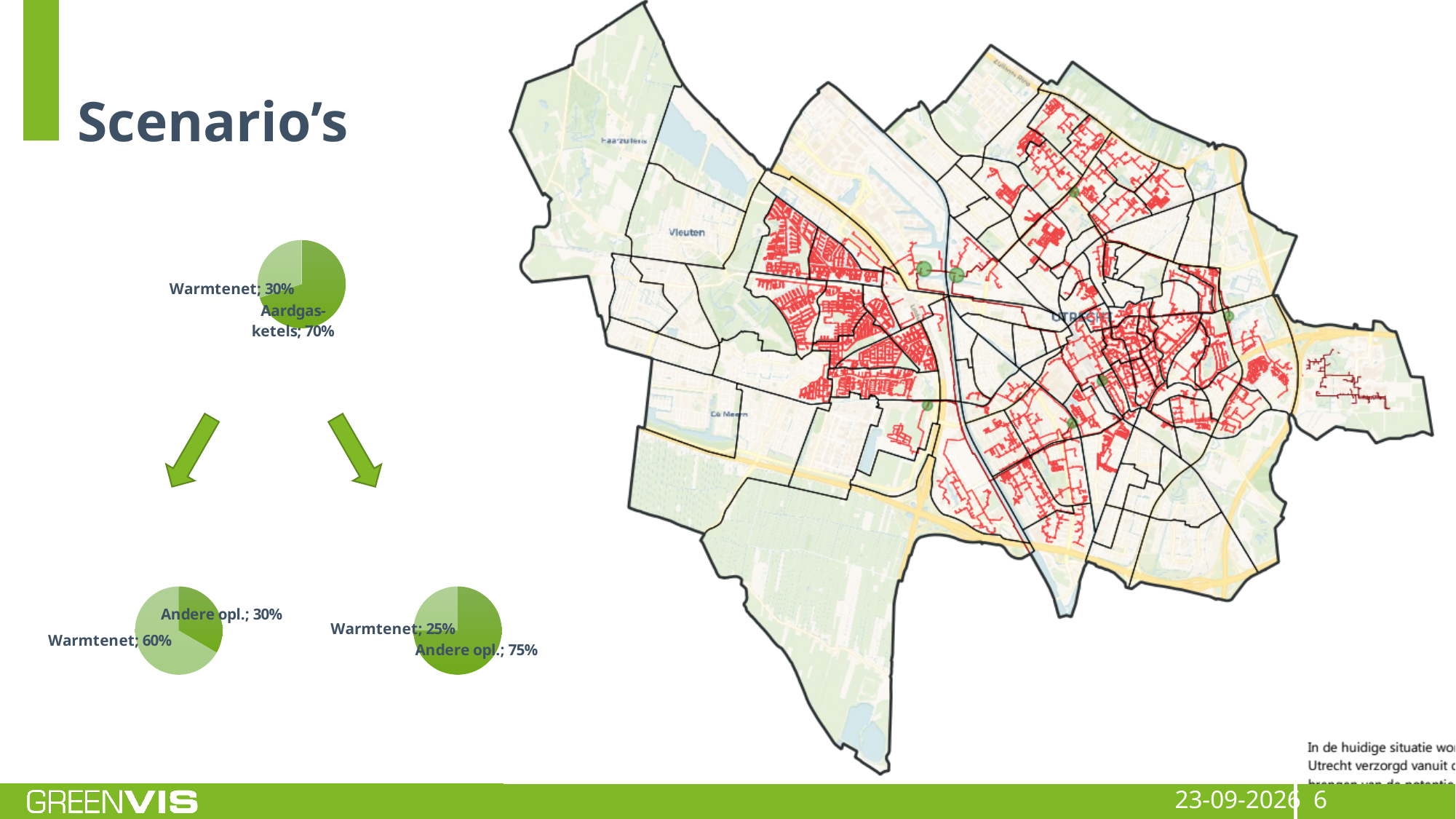
In the top pie chart, what is the difference between the Aardgas-ketels and Warmtenet shares? 40% In the top pie chart, which category has the largest share? Aardgas-ketels How many pie charts are shown on the slide? 3 In the top pie chart, what is the value for Warmtenet? 30% In the bottom-left pie chart, which is larger, Warmtenet or Andere opl.? Warmtenet What kind of chart is the top chart on the left side of the slide? Pie chart In the bottom-left pie chart, what is the value for Warmtenet? 60% In the bottom-right pie chart, which category has the smallest share? Warmtenet In the bottom-right pie chart, what is the value for Warmtenet? 25% In the bottom-right pie chart, what is the value for Andere opl.? 75% In the top pie chart, what is the value for Aardgas-ketels? 70% In the bottom-left pie chart, what is the value for Andere opl.? 30%